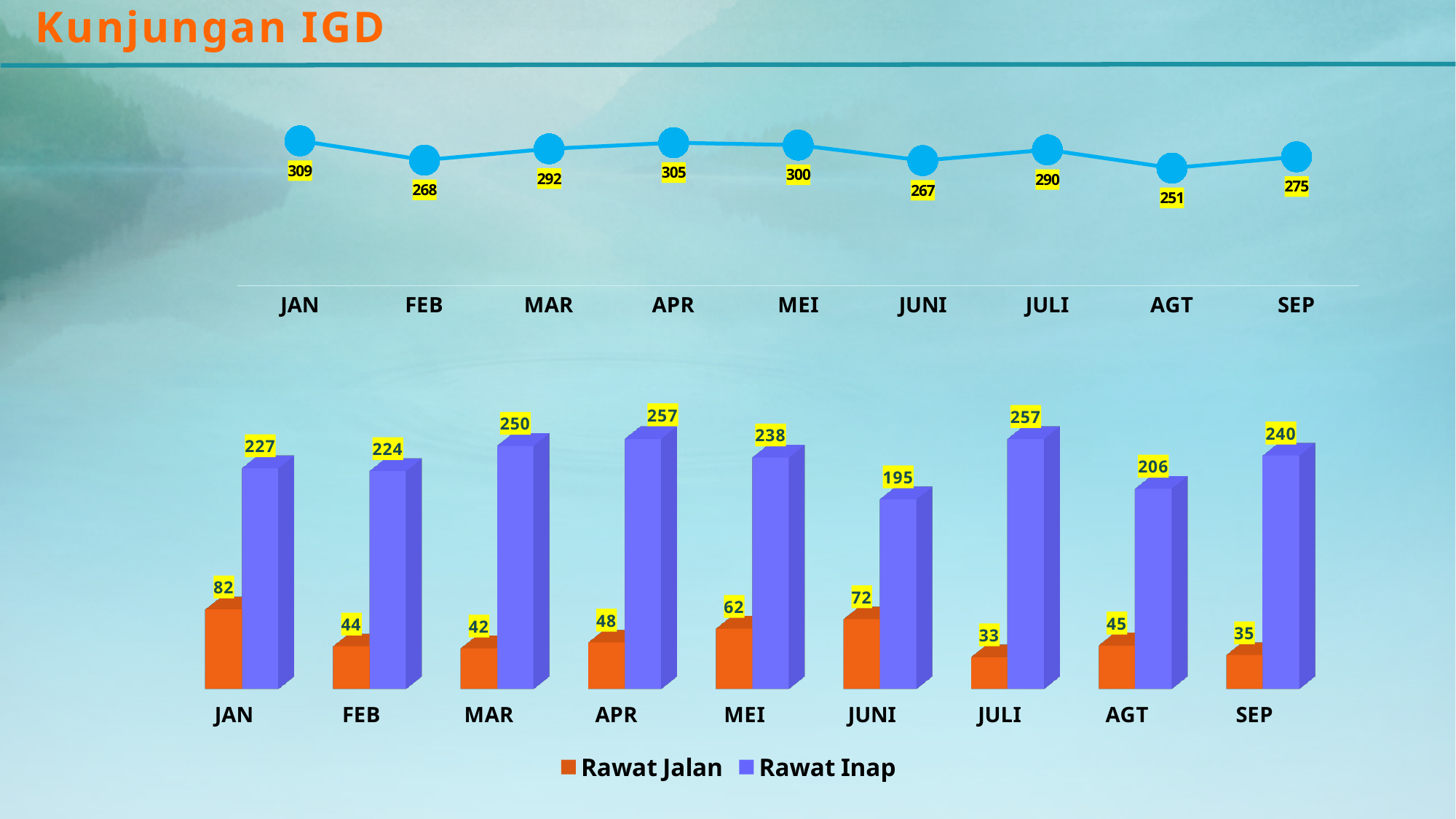
In the bottom bar chart, what is the difference between Rawat Inap and Rawat Jalan for JULI? 224 In the bottom bar chart, what is the Rawat Inap value for MEI? 238 What kind of chart is the top chart on the slide? line chart In the top line chart, which month has the lowest value? AGT In the bottom bar chart, which month has the lowest Rawat Inap value? JUNI In the bottom bar chart, which month has the highest Rawat Jalan value? JAN In the top line chart, what is the value for JAN? 309 In the bottom bar chart, is the Rawat Jalan value for JUNI larger or smaller than the Rawat Jalan value for MEI? larger How many data points are plotted in the top line chart? 9 In the top line chart, what is the difference between the values for APR and JUNI? 38 How many series does the legend of the bottom bar chart list? 2 What kind of chart is the bottom chart on the slide? bar chart